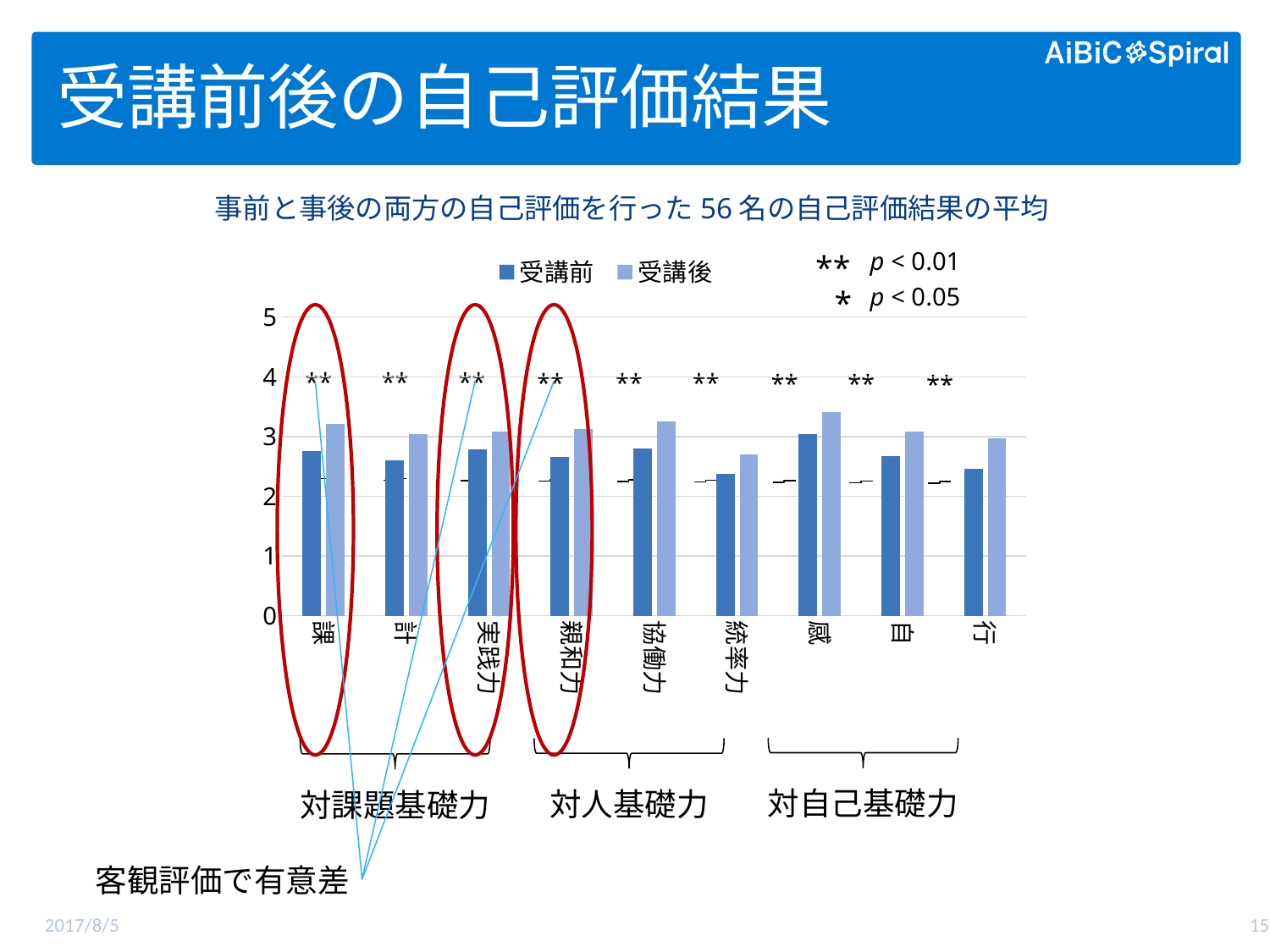
Is the 受講後 value for 統率力 greater or less than 3? less Is the 受講前 value for 実践力 greater or less than 3? less How many categories are plotted along the x axis? 9 What is the maximum value shown on the y axis? 5 What are the two series named in the legend? 受講前 and 受講後 Is the 受講後 value for 協働力 greater or less than 3? greater For 協働力, which is larger: the 受講前 value or the 受講後 value? 受講後 Which is larger: the 受講後 value for 協働力 or the 受講後 value for 統率力? 協働力 How many series does the legend list? 2 What kind of chart is shown on the slide? bar chart